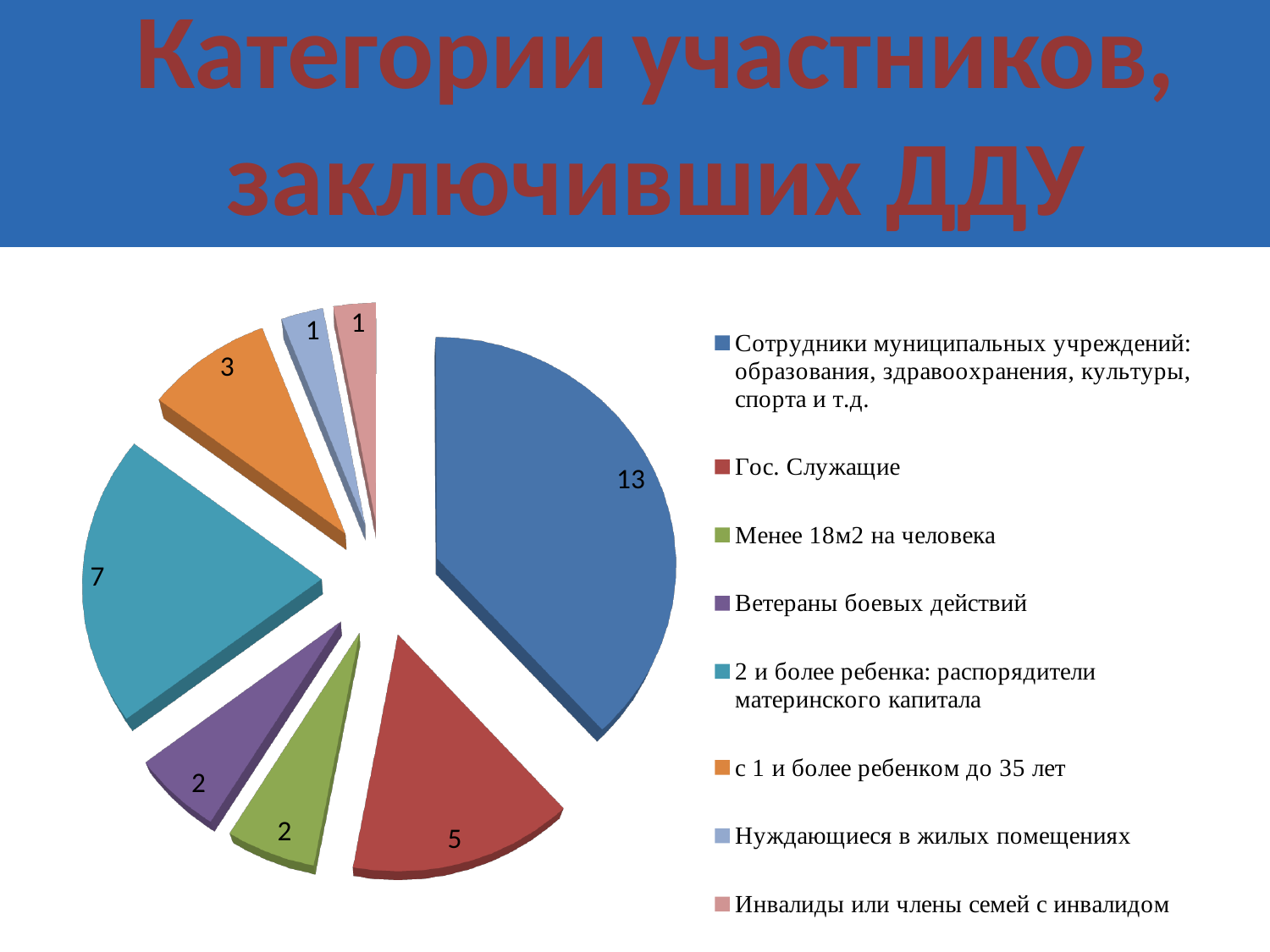
Which is larger: the value for "2 и более ребенка: распорядители материнского капитала" or the value for "Гос. Служащие"? 2 и более ребенка: распорядители материнского капитала What is the value for "с 1 и более ребенком до 35 лет"? 3 What is the total of all the values shown in the pie chart? 34 Which category has the largest slice of the pie? Сотрудники муниципальных учреждений: образования, здравоохранения, культуры, спорта и т.д. What is the title of the slide? Категории участников, заключивших ДДУ What kind of chart is shown on the slide? Pie chart How many categories does the pie chart have? 8 What share of the pie does the "Сотрудники муниципальных учреждений" slice represent? 13 of 34 What is the value for the category "Гос. Служащие"? 5 What is the difference between the value for "Сотрудники муниципальных учреждений" and the value for "Гос. Служащие"? 8 What is the value for "Ветераны боевых действий"? 2 What is the value for "2 и более ребенка: распорядители материнского капитала"? 7